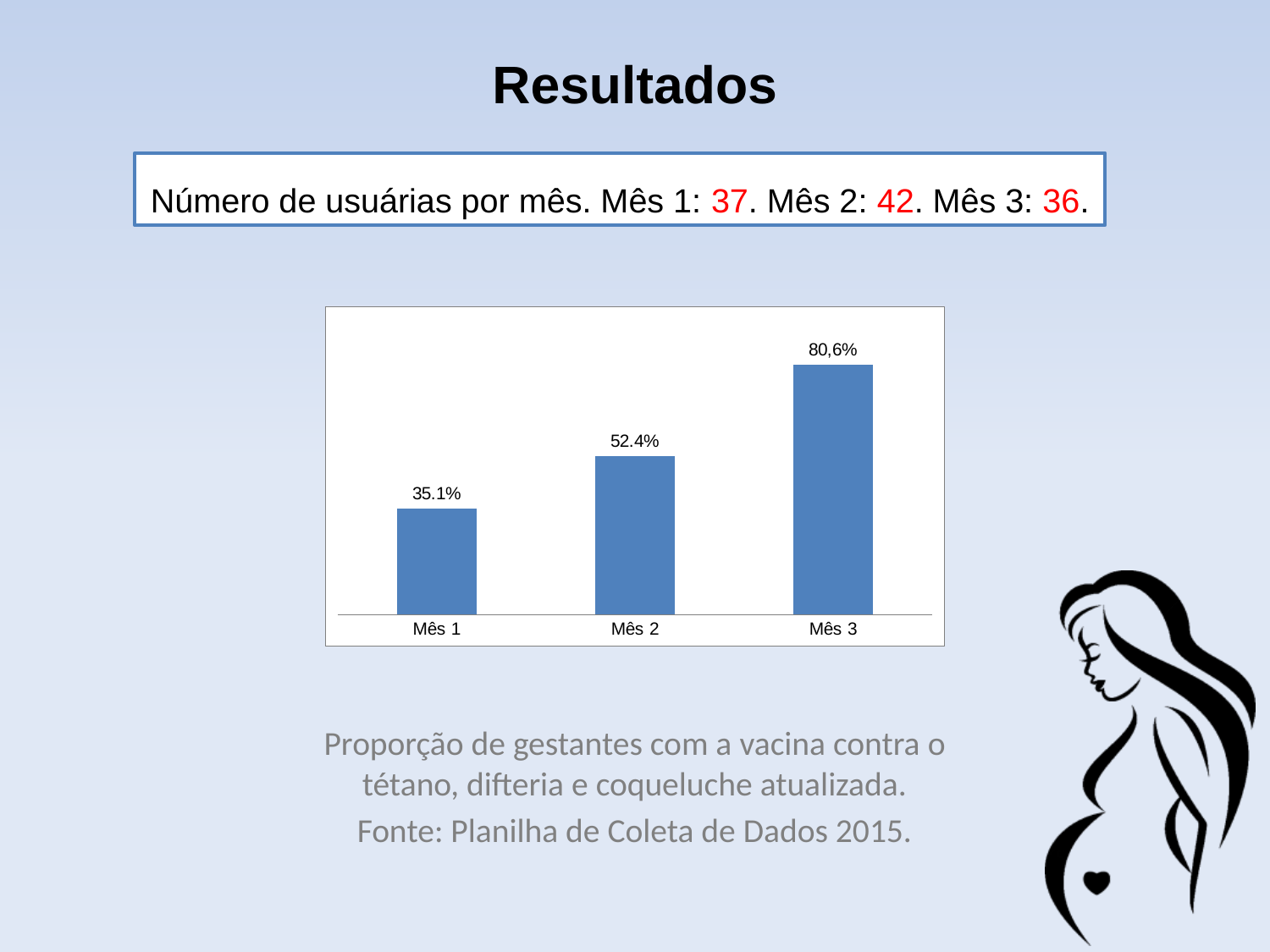
What is the value shown for Mês 3 in the bar chart? 80,6% Which month has the lowest value in the bar chart? Mês 1 What is the value shown for Mês 2 in the bar chart? 52.4% Do the values in the bar chart rise or fall from Mês 1 to Mês 3? Rise According to the caption below the chart, what is the source of the data? Planilha de Coleta de Dados 2015 What colour are the bars in the chart? Blue Which is larger in the bar chart, the value for Mês 2 or the value for Mês 3? Mês 3 What is the difference between the values for Mês 2 and Mês 1 in the bar chart? 17.3% What is the value shown for Mês 1 in the bar chart? 35.1% How many categories (months) are shown in the bar chart? 3 What kind of chart is shown on the slide? Bar chart Which month has the highest value in the bar chart? Mês 3